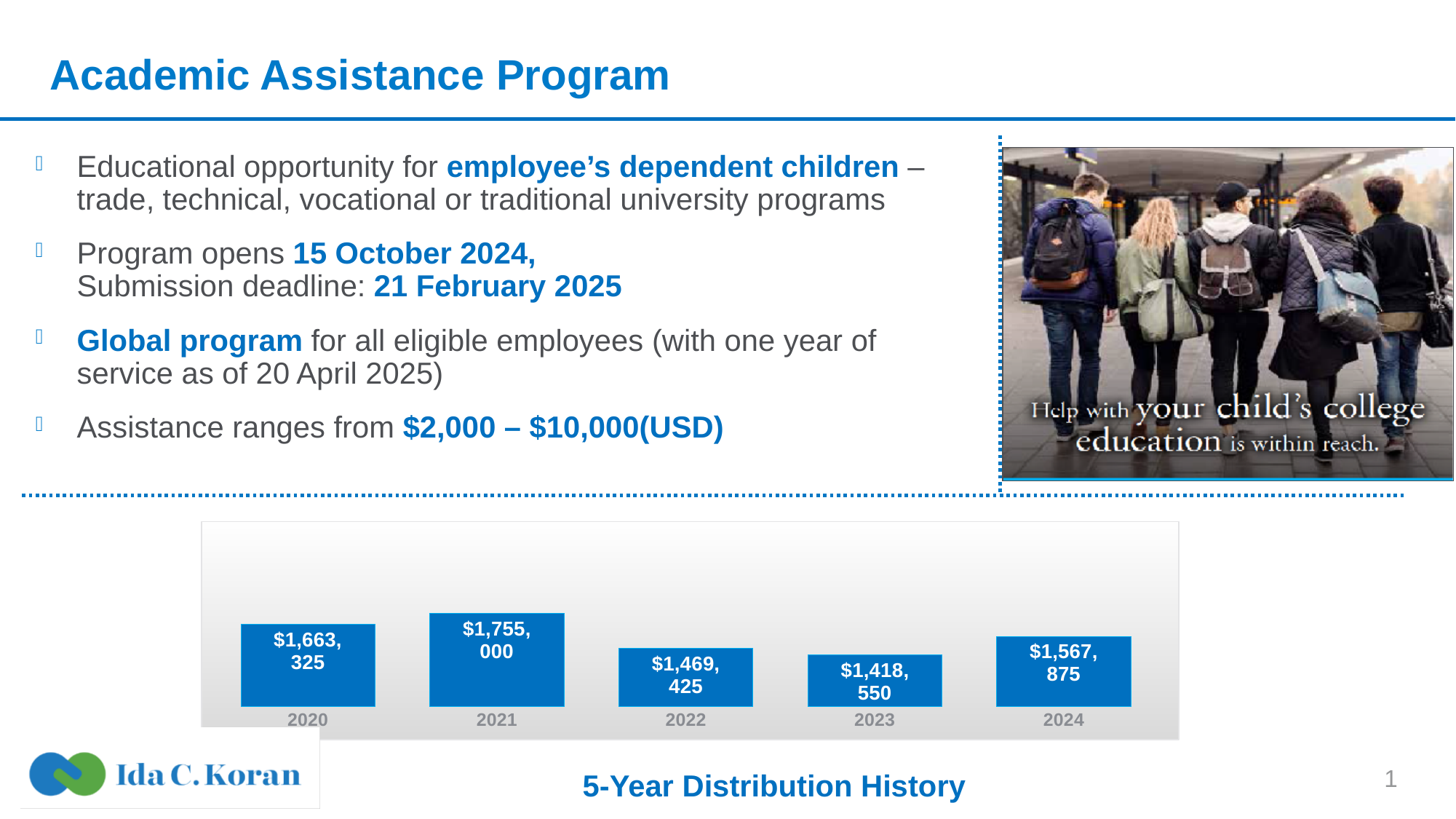
What was the distribution amount in 2024? $1,567,875 Did the distribution amount rise or fall from 2021 to 2023? Fall What is the difference between the 2024 and 2023 distribution amounts? $149,325 Which year had a larger distribution, 2022 or 2024? 2024 Which year had the highest distribution amount? 2021 What is the title of the chart? 5-Year Distribution History How much larger was the 2021 distribution than the 2020 distribution? $91,675 What kind of chart is used to show the distribution history? Bar chart How many years are shown in the chart? 5 What was the distribution amount in 2020? $1,663,325 What was the distribution amount in 2023? $1,418,550 Which year had the lowest distribution amount? 2023